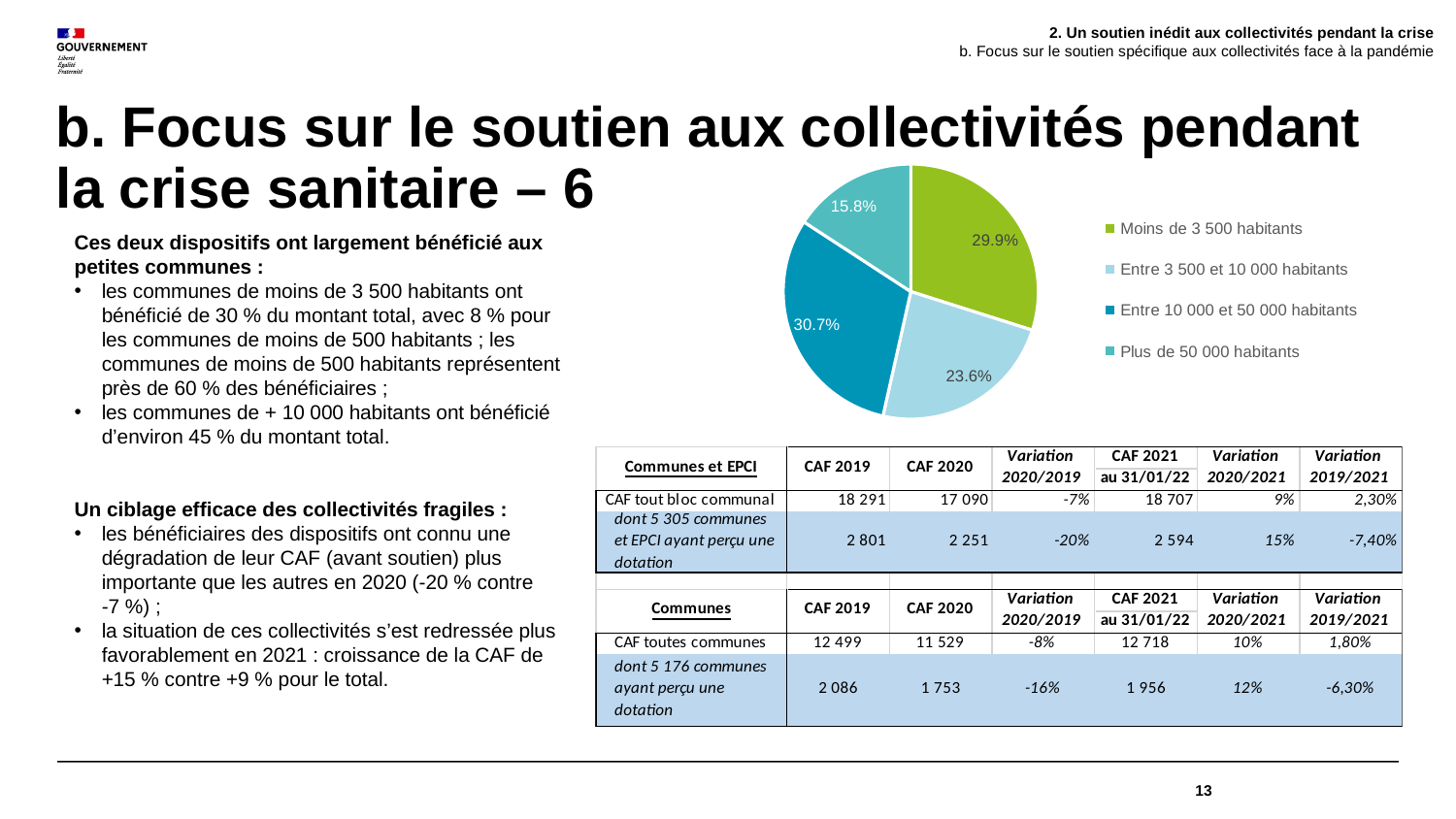
What type of chart is shown on the slide? Pie chart What is the difference in percentage points between the 'Moins de 3 500 habitants' slice and the 'Plus de 50 000 habitants' slice? 14.1 Which slice is larger: 'Entre 3 500 et 10 000 habitants' or 'Plus de 50 000 habitants'? Entre 3 500 et 10 000 habitants How many slices does the pie chart have? 4 Which category has the largest slice in the pie chart? Entre 10 000 et 50 000 habitants What share of the pie chart is labelled 'Entre 10 000 et 50 000 habitants'? 30.7% What share of the pie chart is labelled 'Entre 3 500 et 10 000 habitants'? 23.6% What share of the pie chart is labelled 'Moins de 3 500 habitants'? 29.9% How many entries does the legend of the pie chart list? 4 Which category has the smallest slice in the pie chart? Plus de 50 000 habitants What colour is the 'Moins de 3 500 habitants' slice in the pie chart? Green What share of the pie chart is labelled 'Plus de 50 000 habitants'? 15.8%